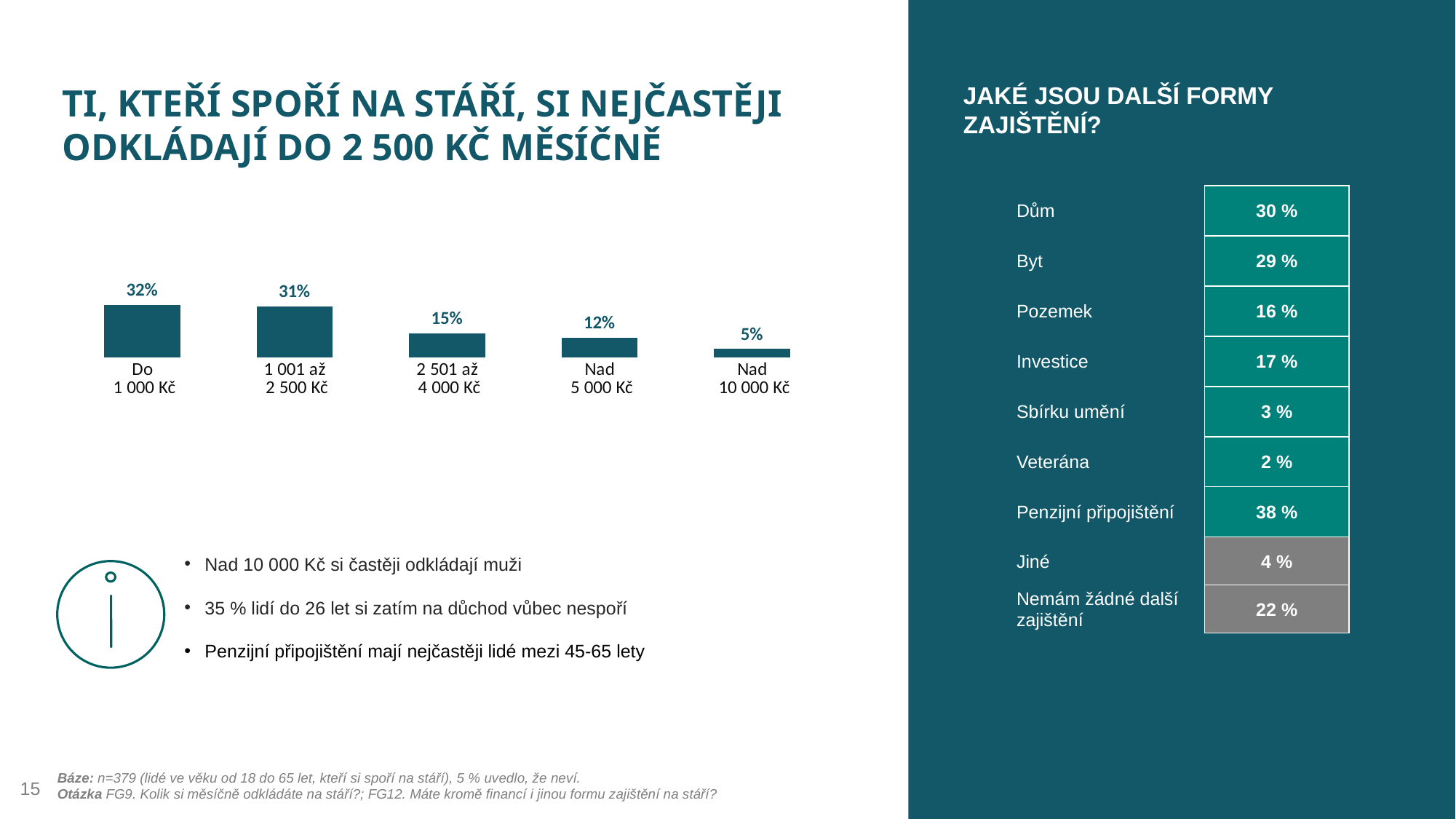
In the bar chart, which category has the highest value? Do 1 000 Kč In the bar chart, what is the value for 'Nad 5 000 Kč'? 12% How many categories does the bar chart show? 5 In the bar chart, what is the difference between the values for '2 501 až 4 000 Kč' and 'Nad 5 000 Kč'? 3% In the bar chart, what is the value for '1 001 až 2 500 Kč'? 31% What kind of chart is shown on the left of the slide? bar chart In the bar chart, what is the value for '2 501 až 4 000 Kč'? 15% In the bar chart, what is the value for 'Do 1 000 Kč'? 32% In the bar chart, which category has the lowest value? Nad 10 000 Kč In the bar chart, which is larger: the value for '2 501 až 4 000 Kč' or the value for 'Nad 10 000 Kč'? 2 501 až 4 000 Kč Do the values in the bar chart rise or fall from left to right along the x axis? fall In the bar chart, what is the value for 'Nad 10 000 Kč'? 5%